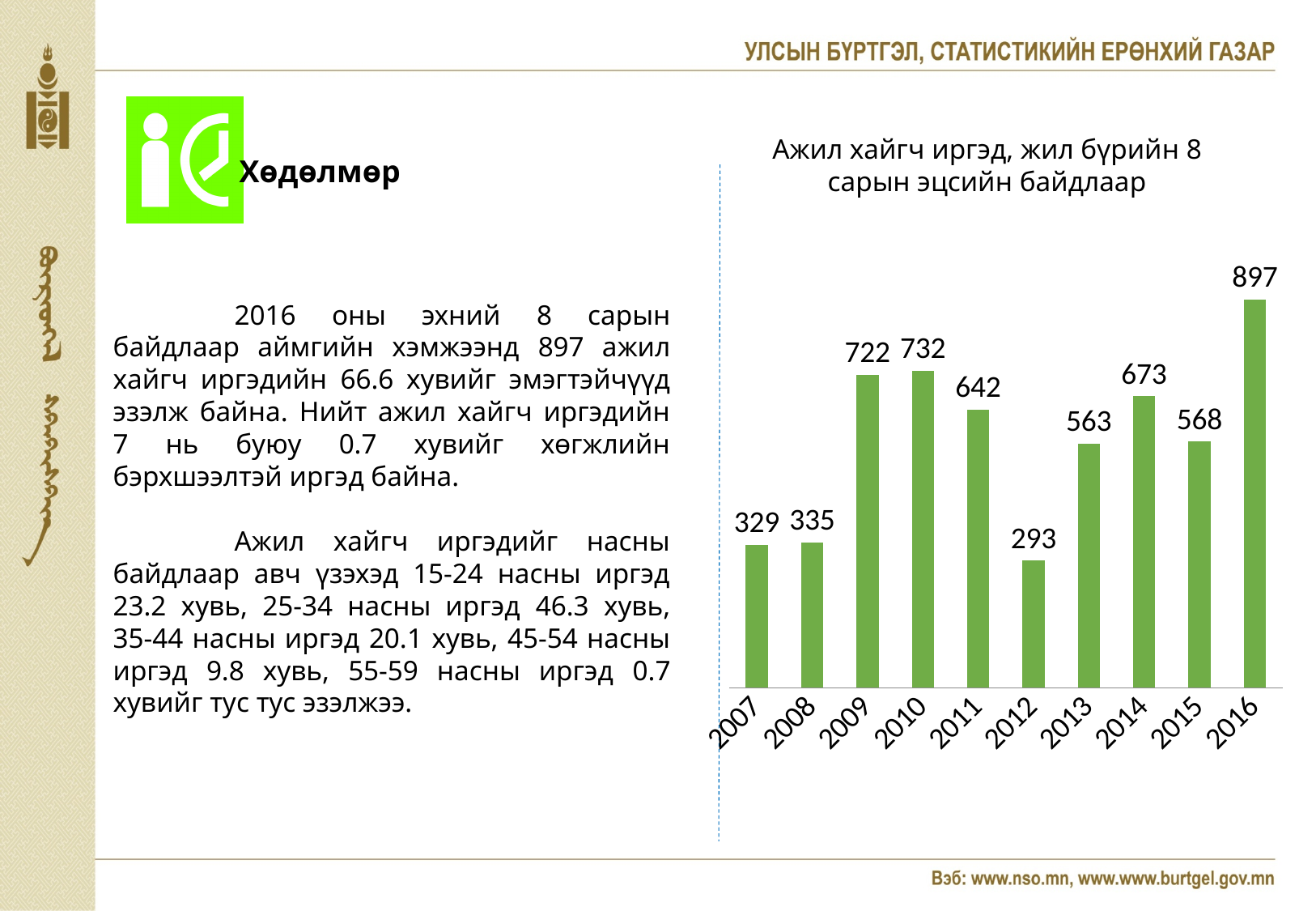
What is the difference between the values for 2010 and 2009? 10 How many years are shown on the x axis? 10 Which is larger, the value for 2011 or the value for 2014? 2014 Do the values rise or fall from 2012 to 2013? rise Which year has the lowest value? 2012 Which year has the highest value? 2016 What kind of chart is this? bar chart What is the value for 2012? 293 What is the value for 2009? 722 What is the value for 2016? 897 What is the difference between the values for 2016 and 2015? 329 What is the title of the chart? Ажил хайгч иргэд, жил бүрийн 8 сарын эцсийн байдлаар